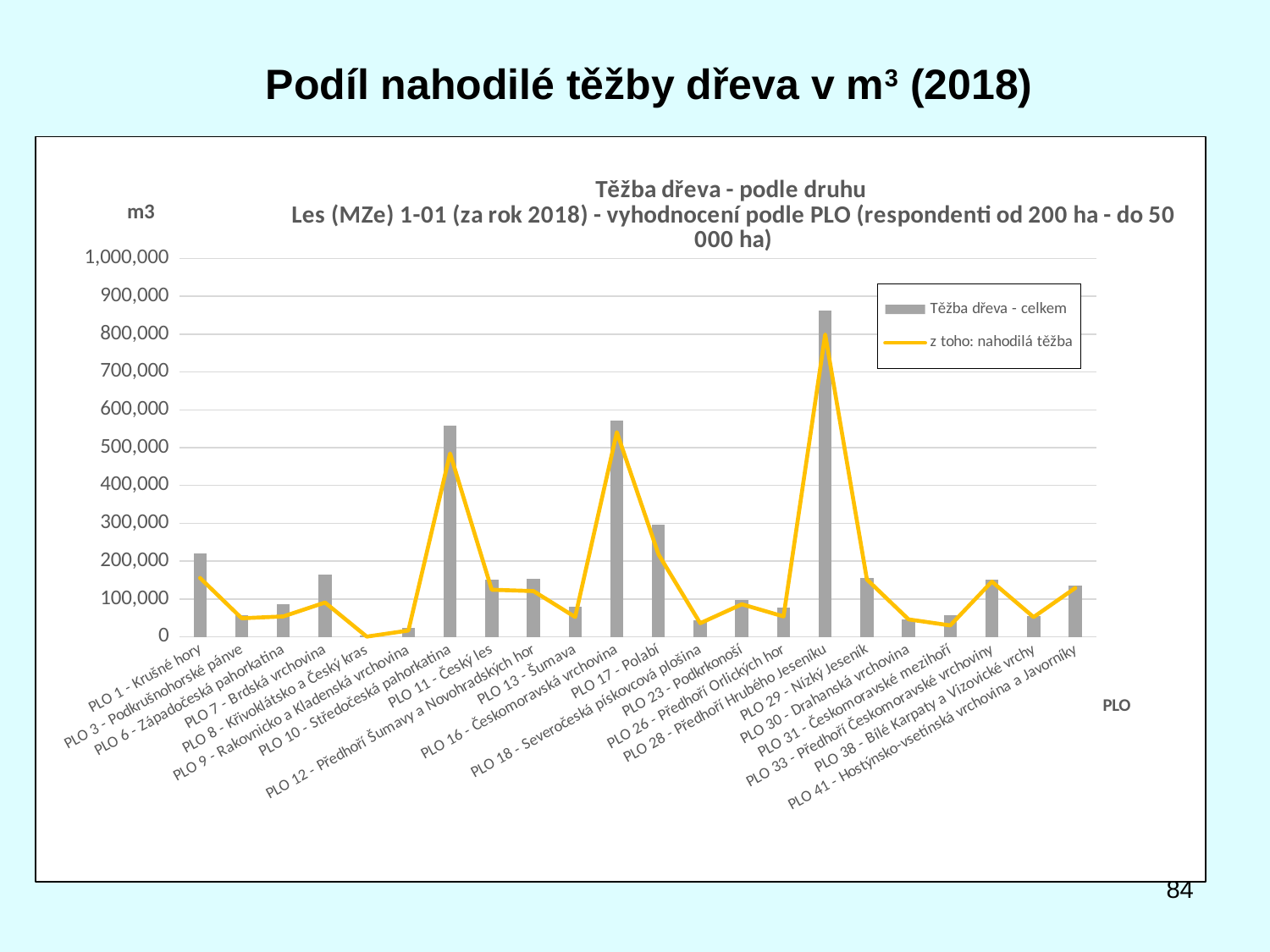
How many series does the chart legend list? 2 Which PLO has the highest total timber harvest (Těžba dřeva - celkem)? PLO 28 - Předhoří Hrubého Jeseníku Which has a larger total harvest, PLO 1 - Krušné hory or PLO 3 - Podkrušnohorské pánve? PLO 1 - Krušné hory What are the two series named in the chart legend? Těžba dřeva - celkem; z toho: nahodilá těžba What kind of chart is shown on the slide? A combined bar and line chart Is the total harvest bar for PLO 1 - Krušné hory greater or less than 200,000? greater Is the total harvest bar for PLO 8 - Křivoklátsko a Český kras greater or less than 100,000? less What unit is shown as the label of the vertical axis? m3 Is the total harvest bar for PLO 10 - Středočeská pahorkatina greater or less than 500,000? greater How many PLO categories are plotted along the x axis? 22 Which has a larger total harvest, PLO 28 - Předhoří Hrubého Jeseníku or PLO 16 - Českomoravská vrchovina? PLO 28 - Předhoří Hrubého Jeseníku